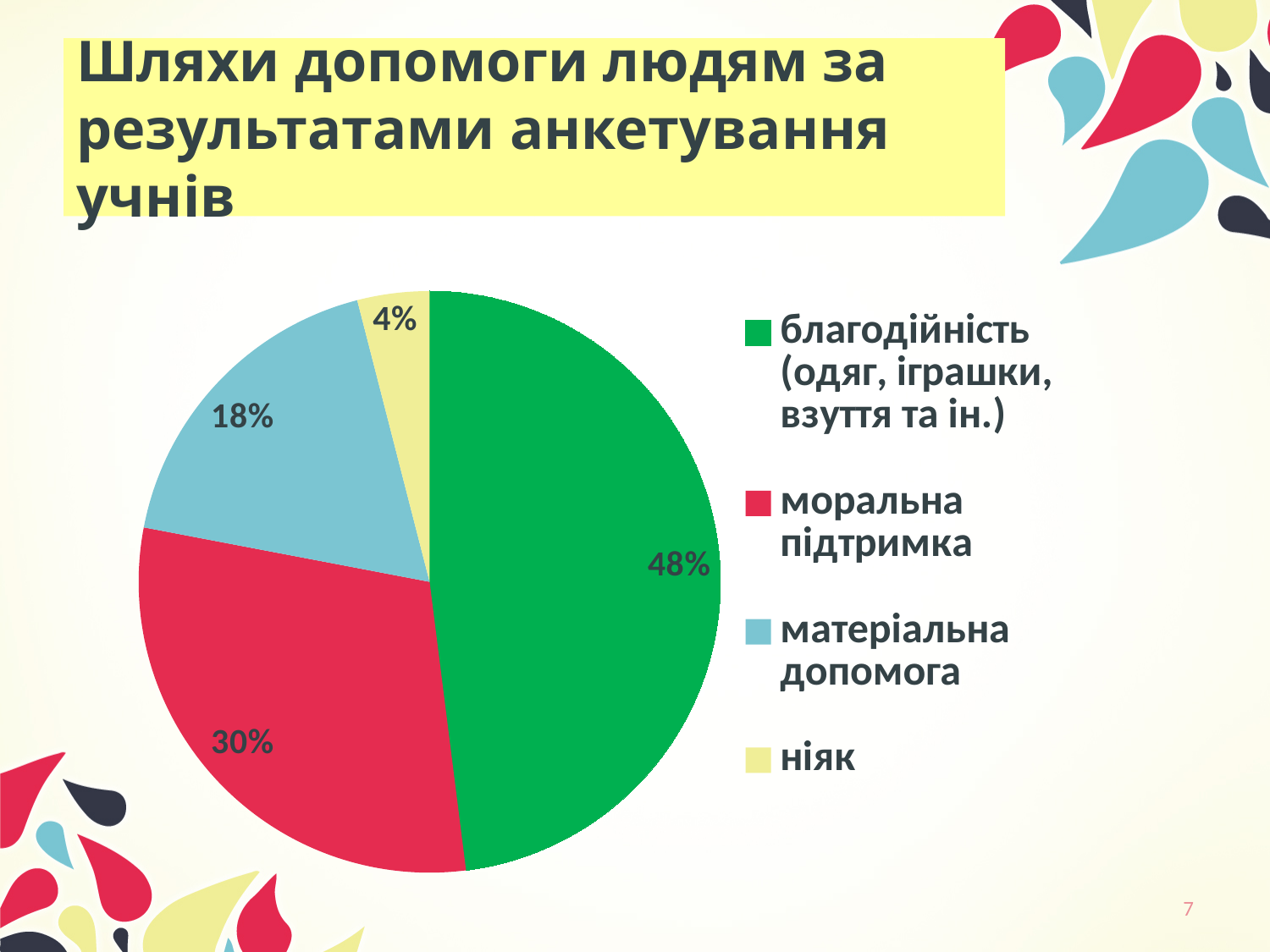
What is the difference in percentage points between "благодійність (одяг, іграшки, взуття та ін.)" and "моральна підтримка"? 18% What share of the pie does "ніяк" take? 4% What is the difference in percentage points between "матеріальна допомога" and "ніяк"? 14% How many categories does the pie chart show? 4 What share of the pie does "благодійність (одяг, іграшки, взуття та ін.)" take? 48% Which is larger: "матеріальна допомога" or "ніяк"? матеріальна допомога What share of the pie does "моральна підтримка" take? 30% What kind of chart is shown on the slide? pie chart Which category has the smallest slice of the pie? ніяк Which category has the largest slice of the pie? благодійність (одяг, іграшки, взуття та ін.) What colour is the slice for "моральна підтримка"? red